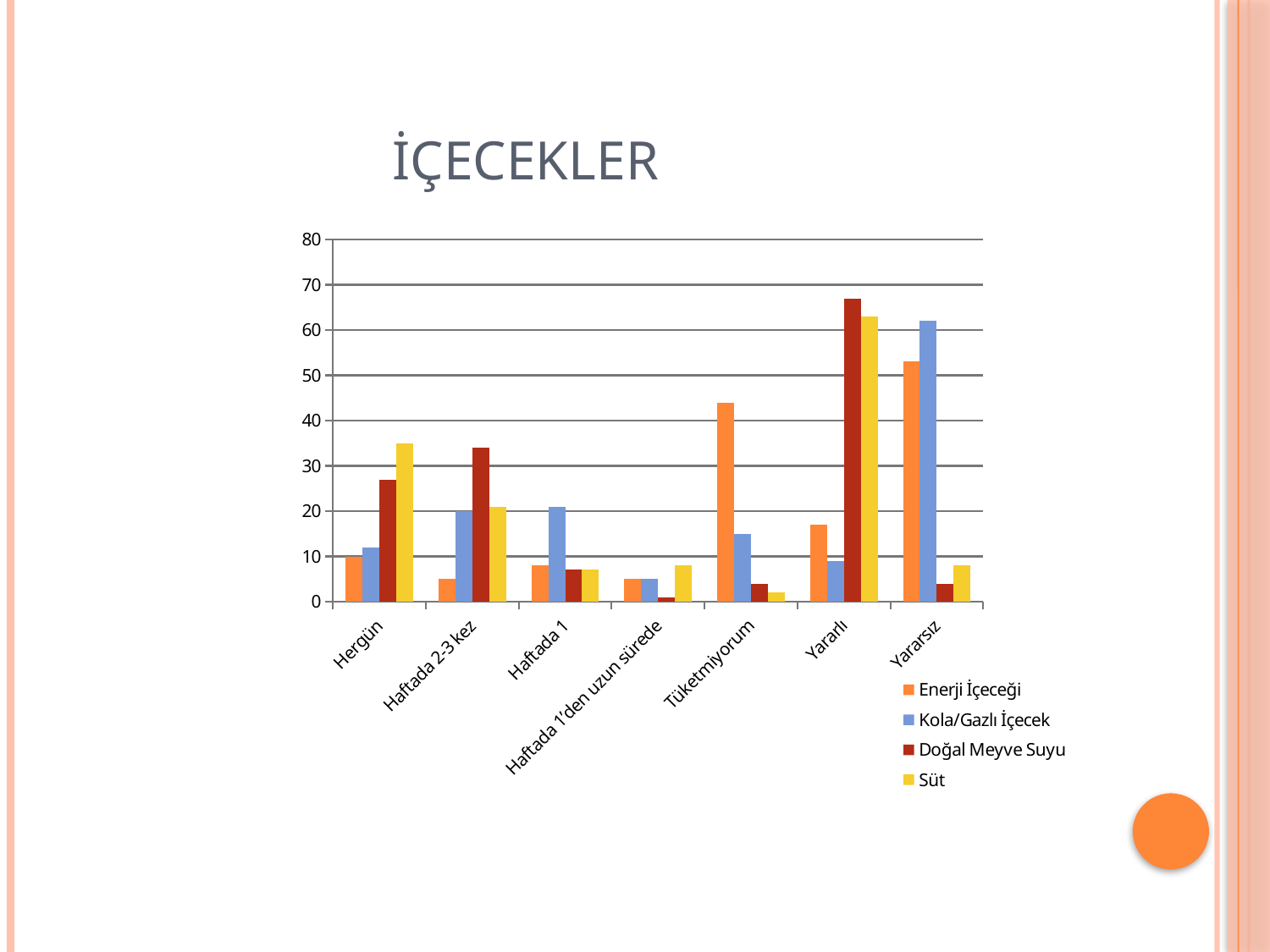
How many categories are shown along the x axis? 7 For the category Tüketmiyorum, which series has the lowest bar? Süt Is the value for Süt in the Hergün category greater or less than 30? greater What is the title of the chart? İÇECEKLER Is the value for Enerji İçeceği in the Tüketmiyorum category greater or less than 40? greater Is the value for Doğal Meyve Suyu in the Haftada 2-3 kez category greater or less than 30? greater For the series Enerji İçeceği, which category has the highest bar? Yararsız How many series does the legend list? 4 What kind of chart is shown on the slide? bar chart For the category Yararlı, which series has the highest bar? Doğal Meyve Suyu In the Yararsız category, which is larger: Kola/Gazlı İçecek or Enerji İçeceği? Kola/Gazlı İçecek In the Hergün category, which is larger: Süt or Doğal Meyve Suyu? Süt